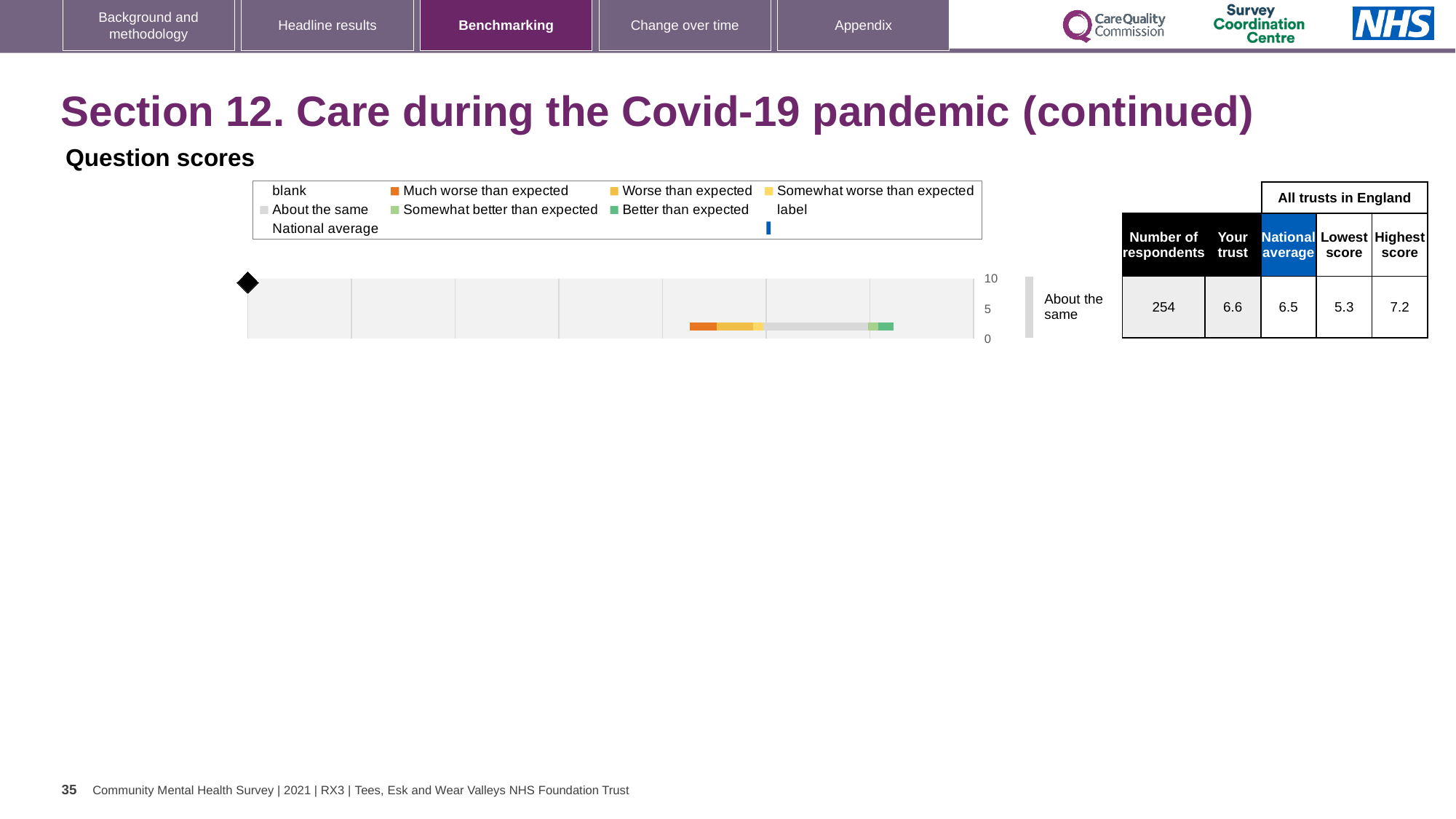
Which is larger, the 'Your trust' score or the national average? Your trust What is the national average score shown in the table? 6.5 Which legend entry is shown in orange? Much worse than expected What kind of chart is used to show the question score? Bar chart What benchmark category label is shown next to the chart for this question? About the same What is the highest score among all trusts in England shown in the table? 7.2 What is the lowest score among all trusts in England shown in the table? 5.3 How many respondents are shown for this question? 254 What is the difference between the highest score and the lowest score among all trusts in England? 1.9 What is the maximum value shown on the chart's score axis? 10 What is the 'Your trust' score shown for the question rated 'About the same'? 6.6 What is the difference between the 'Your trust' score and the national average? 0.1